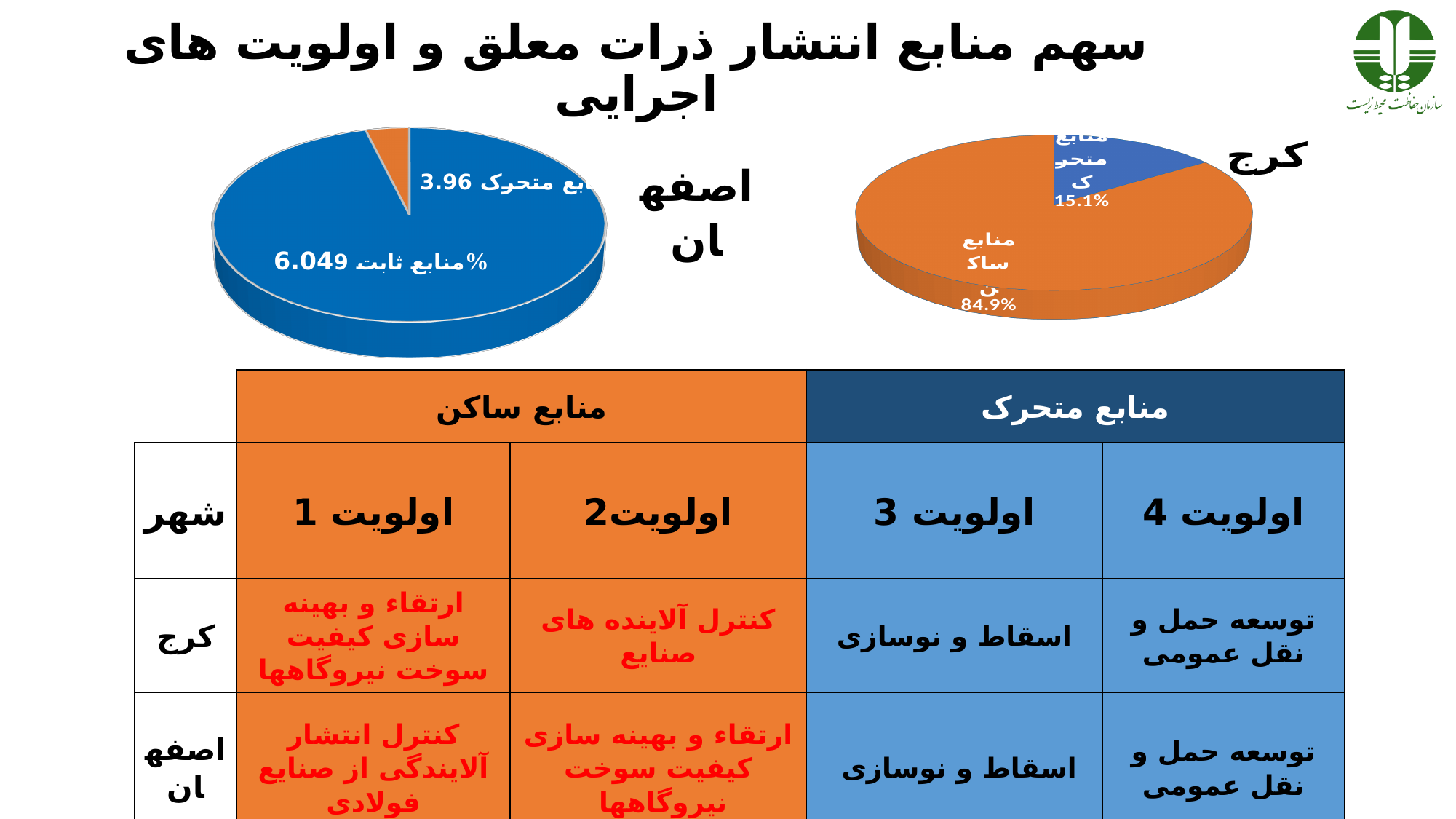
In the Isfahan (اصفهان) pie chart, what colour is the منابع ثابت slice? Blue How many pie charts are on the slide? 2 In the Isfahan (اصفهان) pie chart, which slice is larger: منابع ثابت or منابع متحرک? منابع ثابت In the Karaj (کرج) pie chart, which slice is the largest? منابع ساکن In the Karaj (کرج) pie chart, what is the difference between the منابع ساکن share and the منابع متحرک share? 69.8% In the Karaj (کرج) pie chart, which slice is the smallest? منابع متحرک In the Karaj (کرج) pie chart, what share is labelled for منابع متحرک (mobile sources)? 15.1% In the Karaj (کرج) pie chart, what share is labelled for منابع ساکن (stationary sources)? 84.9% In the Karaj (کرج) pie chart, what colour is the منابع ساکن slice? Orange Which city's pie chart shows the larger share for mobile sources (منابع متحرک), Karaj or Isfahan? Karaj (کرج) In the Isfahan (اصفهان) pie chart, how many slices are there? 2 What kind of charts are shown on the slide? Pie charts